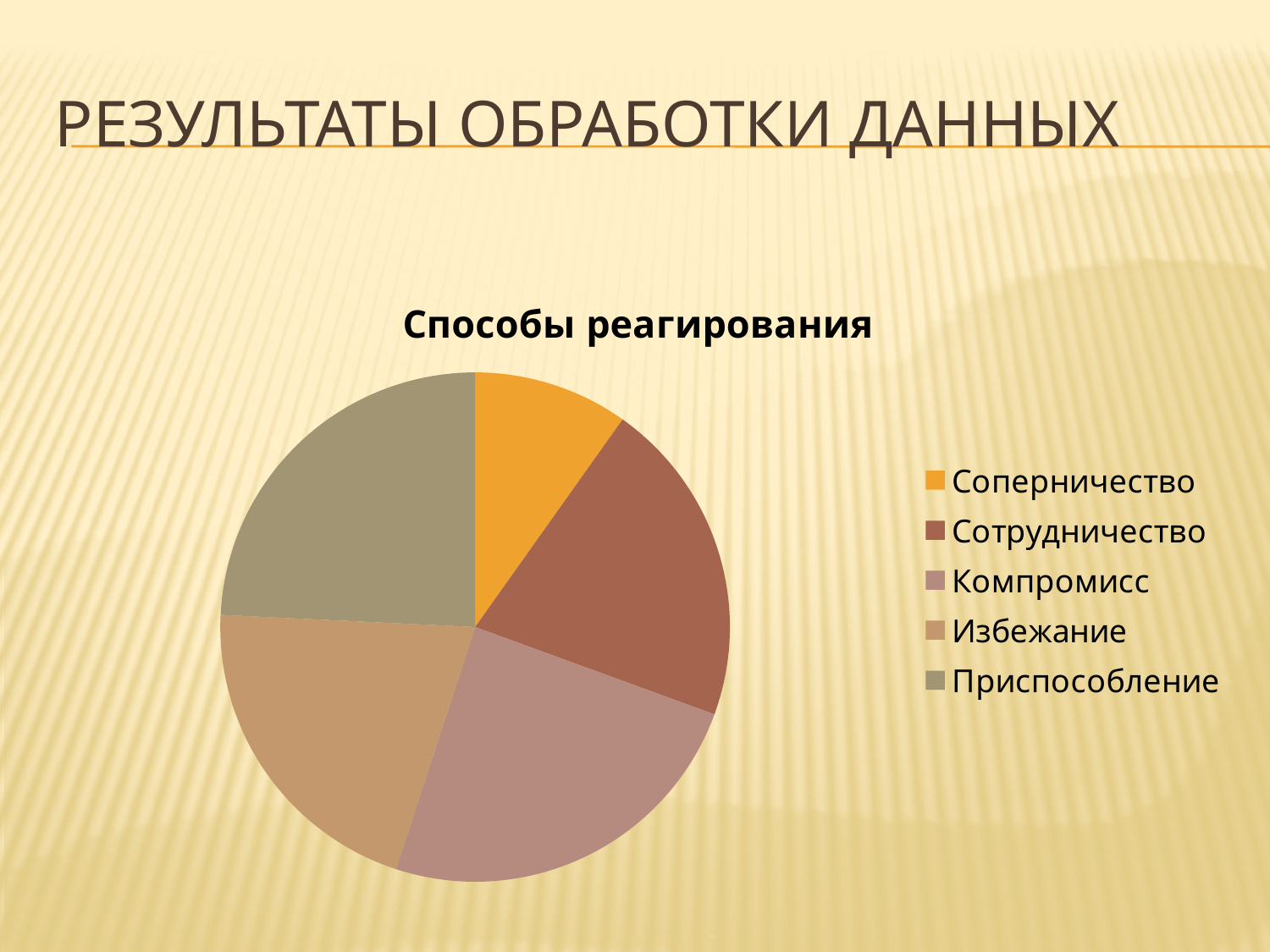
Which slice is larger, Приспособление or Соперничество? Приспособление What kind of chart is shown on the slide? pie chart What is the title of the chart? Способы реагирования Which slice is larger, Соперничество or Избежание? Избежание Which category has the smallest slice of the pie? Соперничество Which slice is larger, Соперничество or Сотрудничество? Сотрудничество How many entries does the legend list? 5 How many slices does the pie chart have? 5 What colour is the Соперничество slice? orange